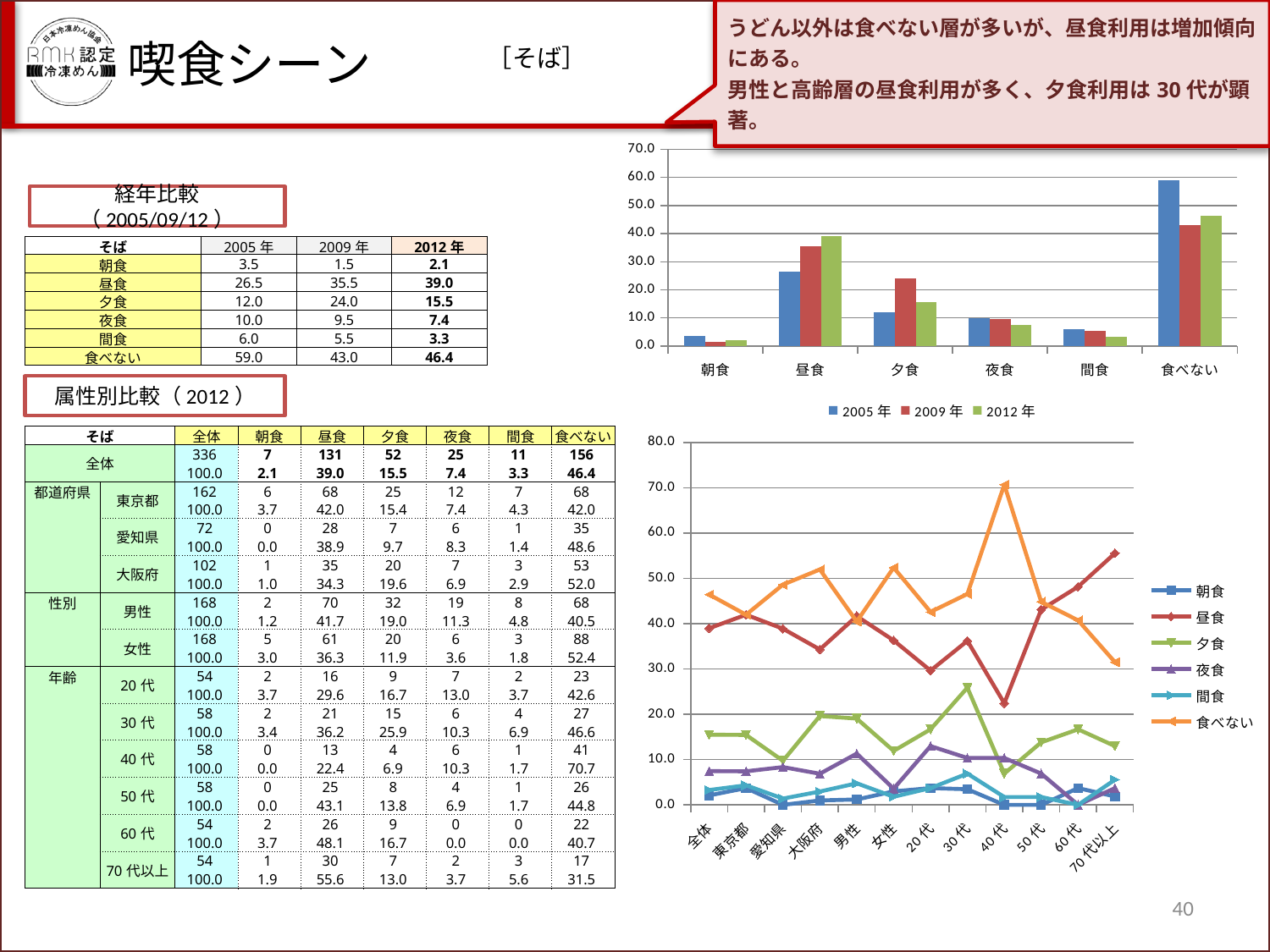
In the top-right bar chart, is the value for 食べない in 2005年 greater or less than 50? greater In the bottom-right line chart, how many categories are shown on the x axis? 12 In the top-right bar chart, what is the value for 昼食 in 2012年 (as printed in the 経年比較 table)? 39.0 In the bottom-right line chart, how many series does the legend list? 6 In the top-right bar chart, is the value for 夕食 in 2009年 greater or less than 20? greater What kind of chart is the chart at the top right of the slide? bar chart In the bottom-right line chart, at which category does the 食べない series reach its highest value? 40代 In the top-right bar chart, which is larger for 昼食: the 2009年 value or the 2012年 value? 2012年 In the bottom-right line chart, is the value of 昼食 for 70代以上 greater or less than 50? greater In the top-right bar chart, which category has the highest value for 2012年? 食べない In the top-right bar chart, how many series does the legend list? 3 What kind of chart is the chart at the bottom right of the slide? line chart